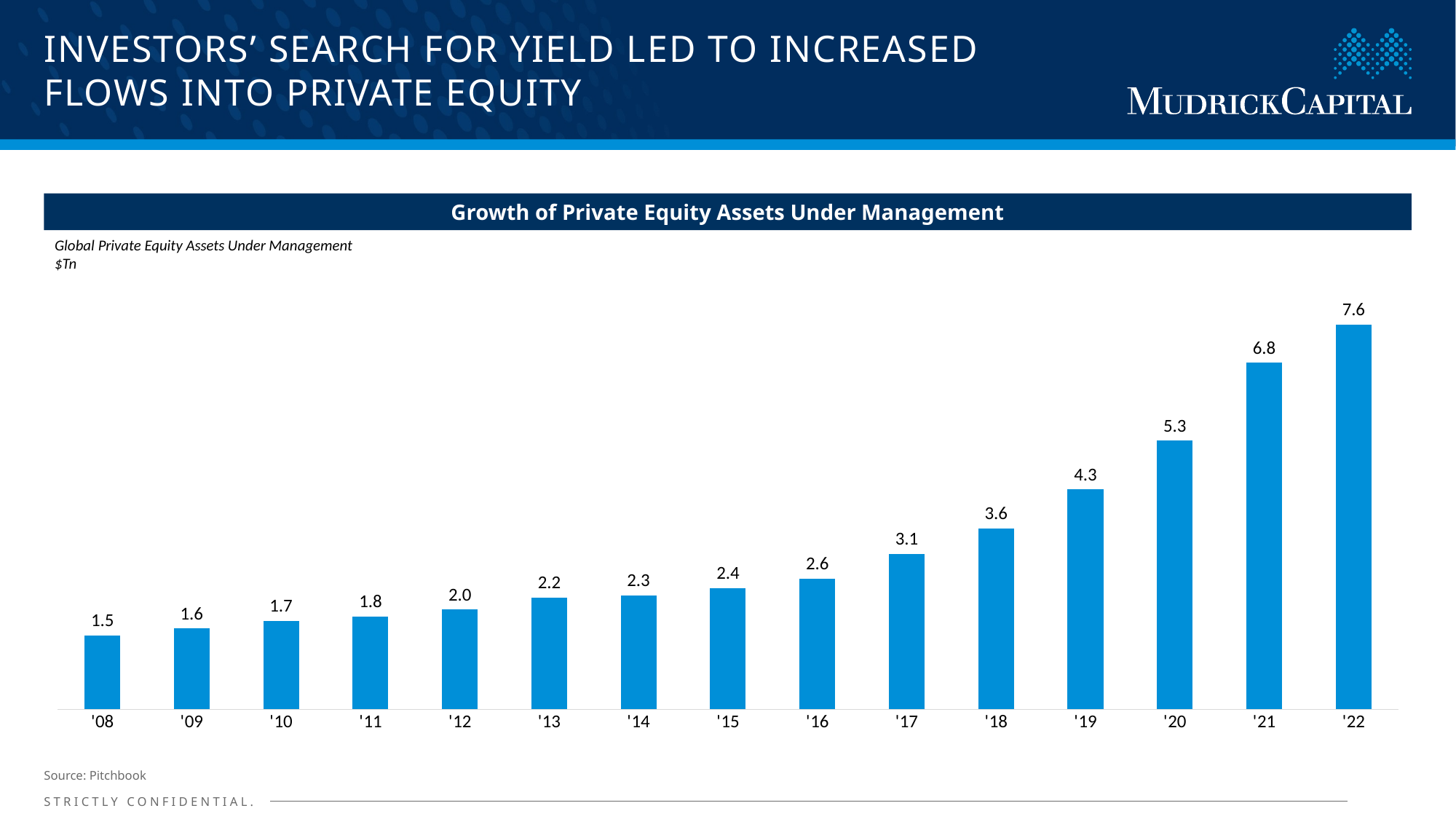
What is the difference between the values for '22 and '21? 0.8 How many years are shown on the x axis? 15 Which year has the highest value? '22 What kind of chart is this? Bar chart What is the value for '08? 1.5 What is the value for '20? 5.3 What is the title of the chart? Growth of Private Equity Assets Under Management What is the value for '15? 2.4 Which is larger, the value for '17 or the value for '18? '18 Do the values rise or fall from '08 to '22? Rise What is the difference between the values for '19 and '08? 2.8 Which year has the lowest value? '08